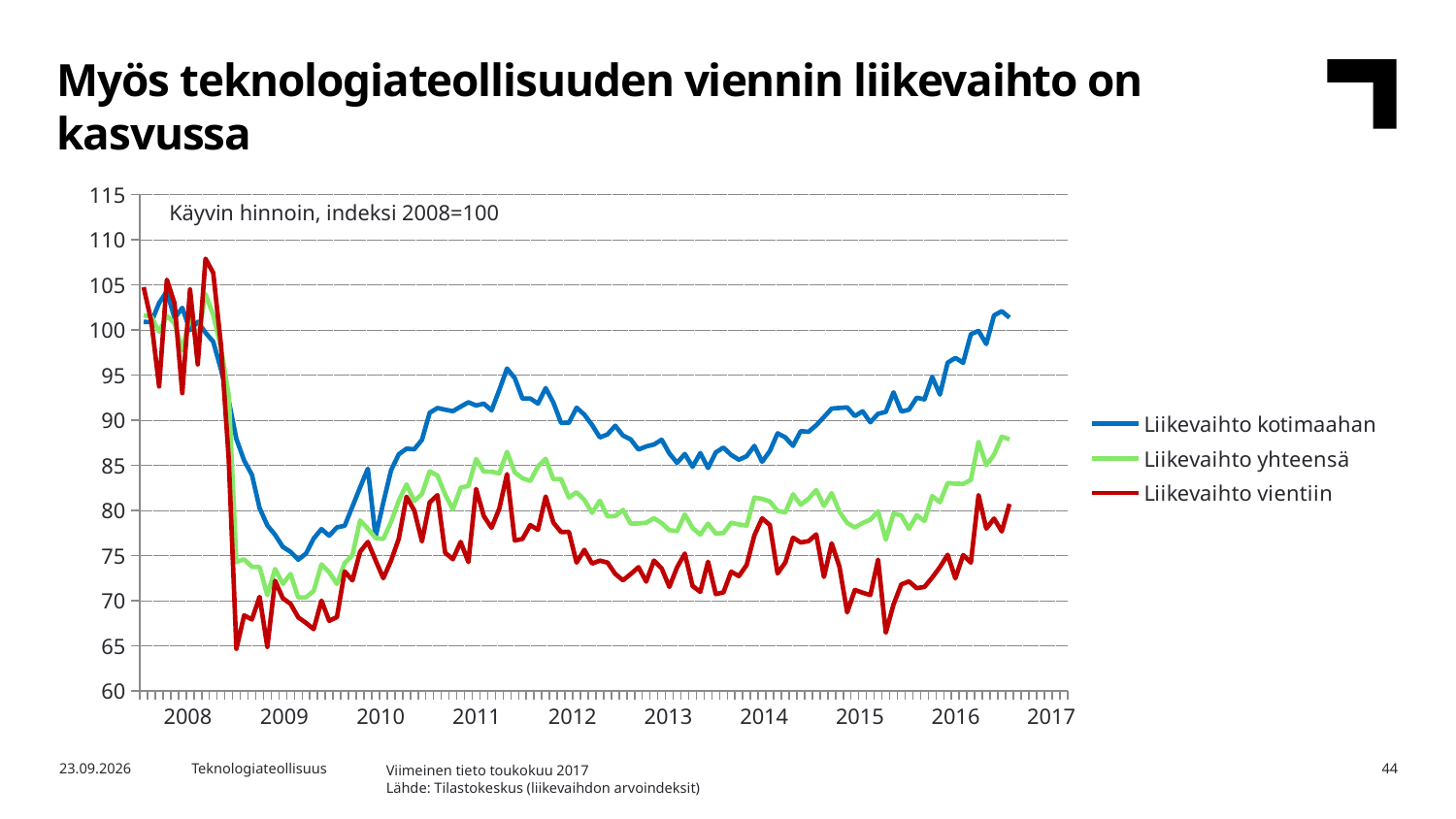
How many series does the legend list? 3 Which is larger in 2016: Liikevaihto kotimaahan or Liikevaihto vientiin? Liikevaihto kotimaahan Does Liikevaihto kotimaahan rise or fall from 2014 to 2017? rise Which series has the highest value at the end of the series in 2017? Liikevaihto kotimaahan Is the value for Liikevaihto yhteensä at the end of the series (2017) greater or less than 85? greater Which series has the lowest value at the end of the series in 2017? Liikevaihto vientiin Is the lowest value for Liikevaihto vientiin in 2009 greater or less than 70? less What is the subtitle text shown inside the chart area? Käyvin hinnoin, indeksi 2008=100 What kind of chart is shown on the slide? line chart Which series is shown in blue? Liikevaihto kotimaahan Is the value for Liikevaihto kotimaahan at the end of the series (2017) greater or less than 100? greater